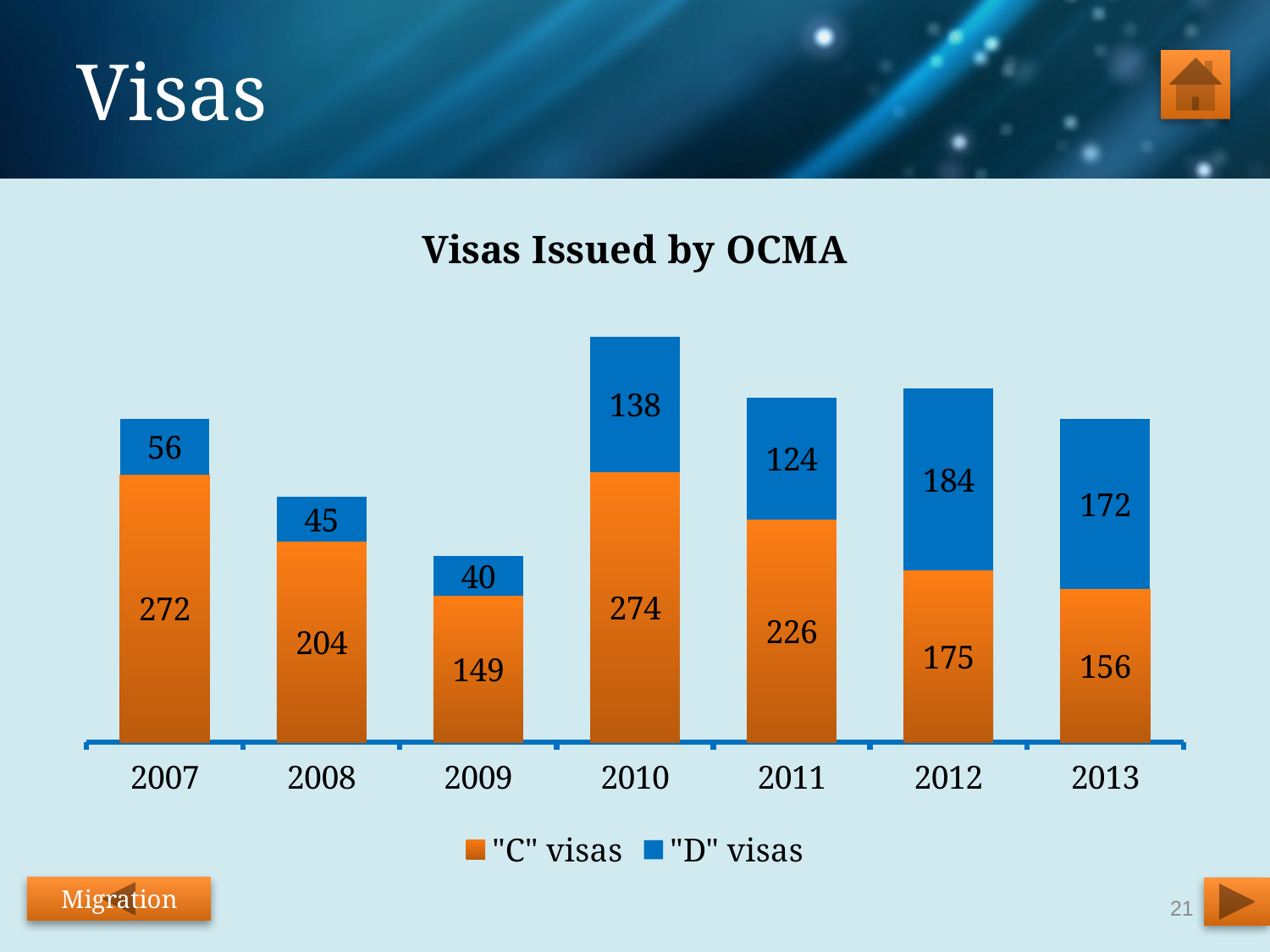
What is the total number of visas issued in 2011? 350 Which year has the tallest stacked bar (highest total visas)? 2010 In which year were the fewest "C" visas issued? 2009 How many "D" visas were issued in 2013? 172 In which year were the most "D" visas issued? 2012 How many "C" visas were issued in 2010? 274 How many series does the legend list? 2 How many years are shown on the x axis? 7 Which is larger in 2012: the number of "C" visas or the number of "D" visas? "D" visas What is the title of the chart? Visas Issued by OCMA What type of chart is shown on the slide? Stacked bar chart What is the difference between "C" visas issued in 2007 and in 2008? 68